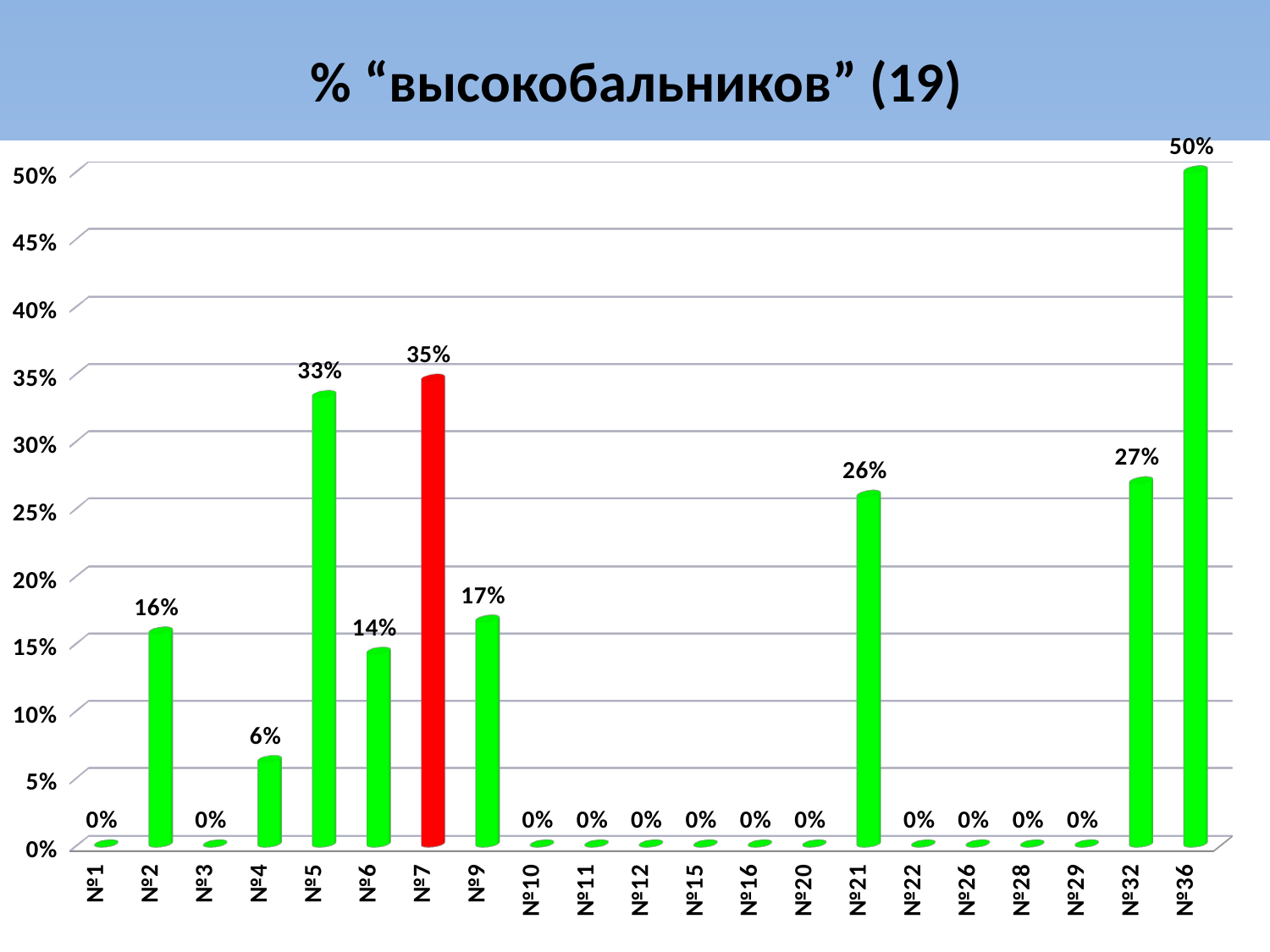
What is the value for №4? 6% Which bar is coloured red instead of green? №7 What is the value for №7? 35% What kind of chart is shown on the slide? bar chart How many categories are shown on the x axis? 21 Which is larger, the value for №6 or the value for №32? №32 Which is larger, the value for №2 or the value for №9? №9 Which category has the highest value? №36 What is the difference between the values for №36 and №7? 15% How many categories have a value of 0%? 12 What is the value for №21? 26% What is the difference between the values for №5 and №32? 6%